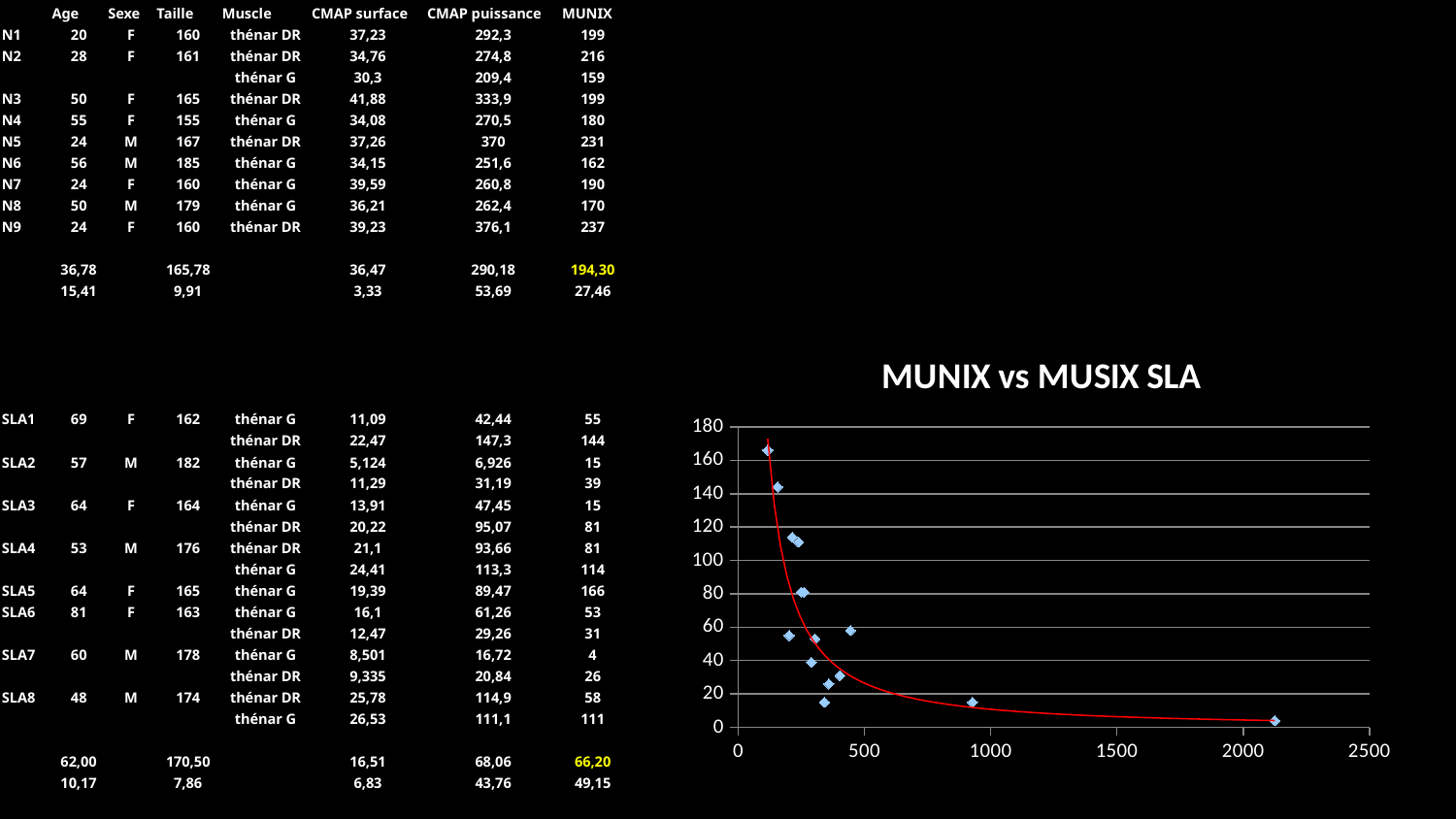
What is the highest tick value shown on the x axis of the 'MUNIX vs MUSIX SLA' chart? 2500 In the 'MUNIX vs MUSIX SLA' chart, which has the larger y value: the point near x = 100 or the point near x = 2100? the point near x = 100 In the 'MUNIX vs MUSIX SLA' chart, is the y value of the highest point greater or less than 160? greater What kind of chart is the 'MUNIX vs MUSIX SLA' chart? scatter chart In the 'MUNIX vs MUSIX SLA' chart, do the y values rise or fall as the x values increase? fall In the 'MUNIX vs MUSIX SLA' chart, is the y value of the point near x = 450 greater or less than 40? greater In the 'MUNIX vs MUSIX SLA' chart, is the y value of the point near x = 900 greater or less than 40? less What is the title of the chart on the slide? MUNIX vs MUSIX SLA